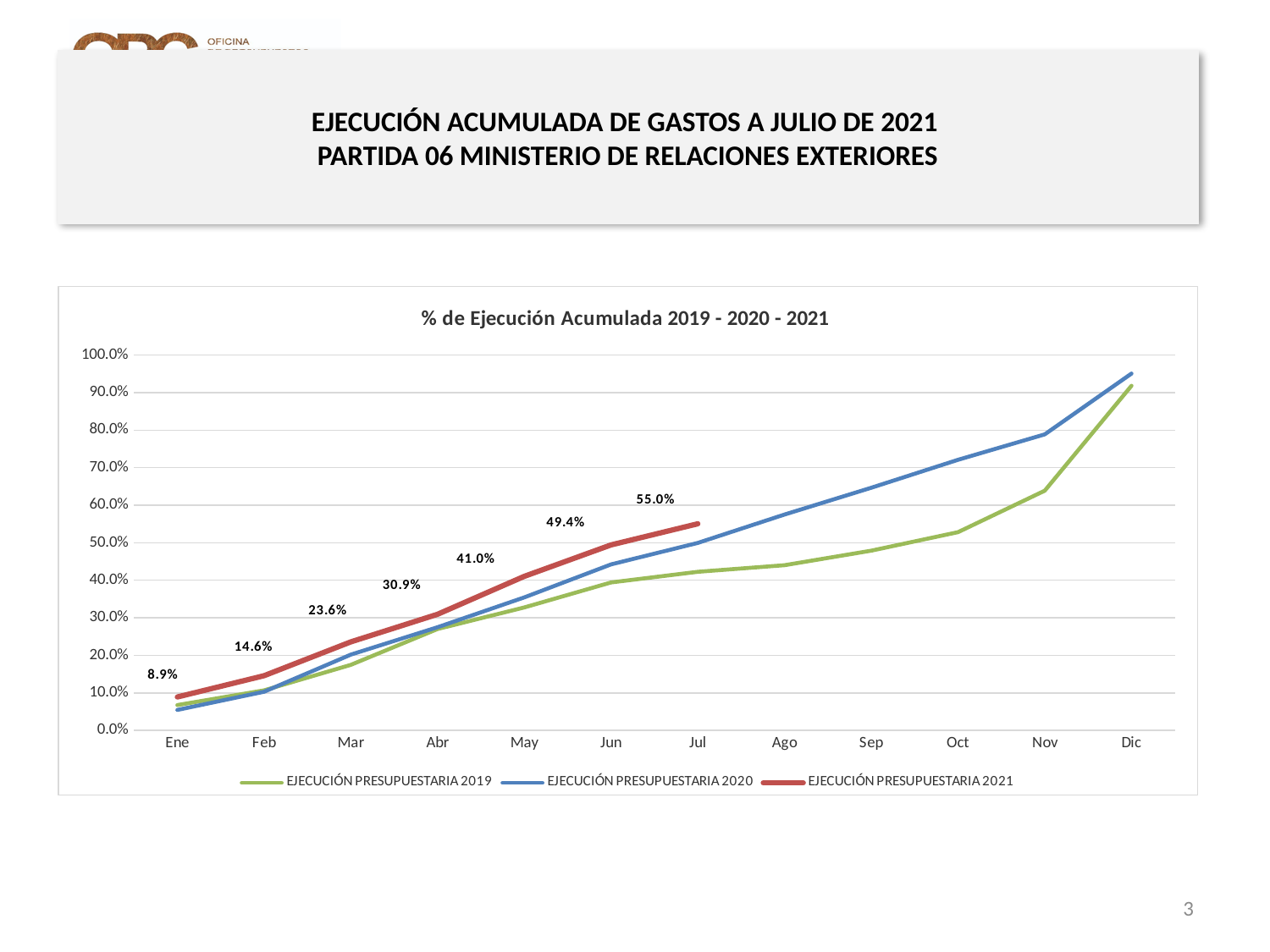
What is the value for EJECUCIÓN PRESUPUESTARIA 2021 in Ene? 8.9% What is the title of the chart? % de Ejecución Acumulada 2019 - 2020 - 2021 What type of chart is shown on the slide? line chart How many months are shown on the x axis? 12 Which month has the highest value for EJECUCIÓN PRESUPUESTARIA 2021? Jul What is the difference between the EJECUCIÓN PRESUPUESTARIA 2021 values for Jul and Jun? 5.6% What is the difference between the EJECUCIÓN PRESUPUESTARIA 2021 values for May and Mar? 17.4% How many series does the legend list? 3 What is the value for EJECUCIÓN PRESUPUESTARIA 2021 in Jul? 55.0% Is the value for EJECUCIÓN PRESUPUESTARIA 2020 in Dic greater or less than 90.0%? greater What is the value for EJECUCIÓN PRESUPUESTARIA 2021 in Abr? 30.9% Do the values for EJECUCIÓN PRESUPUESTARIA 2019 rise or fall from Ene to Dic? rise